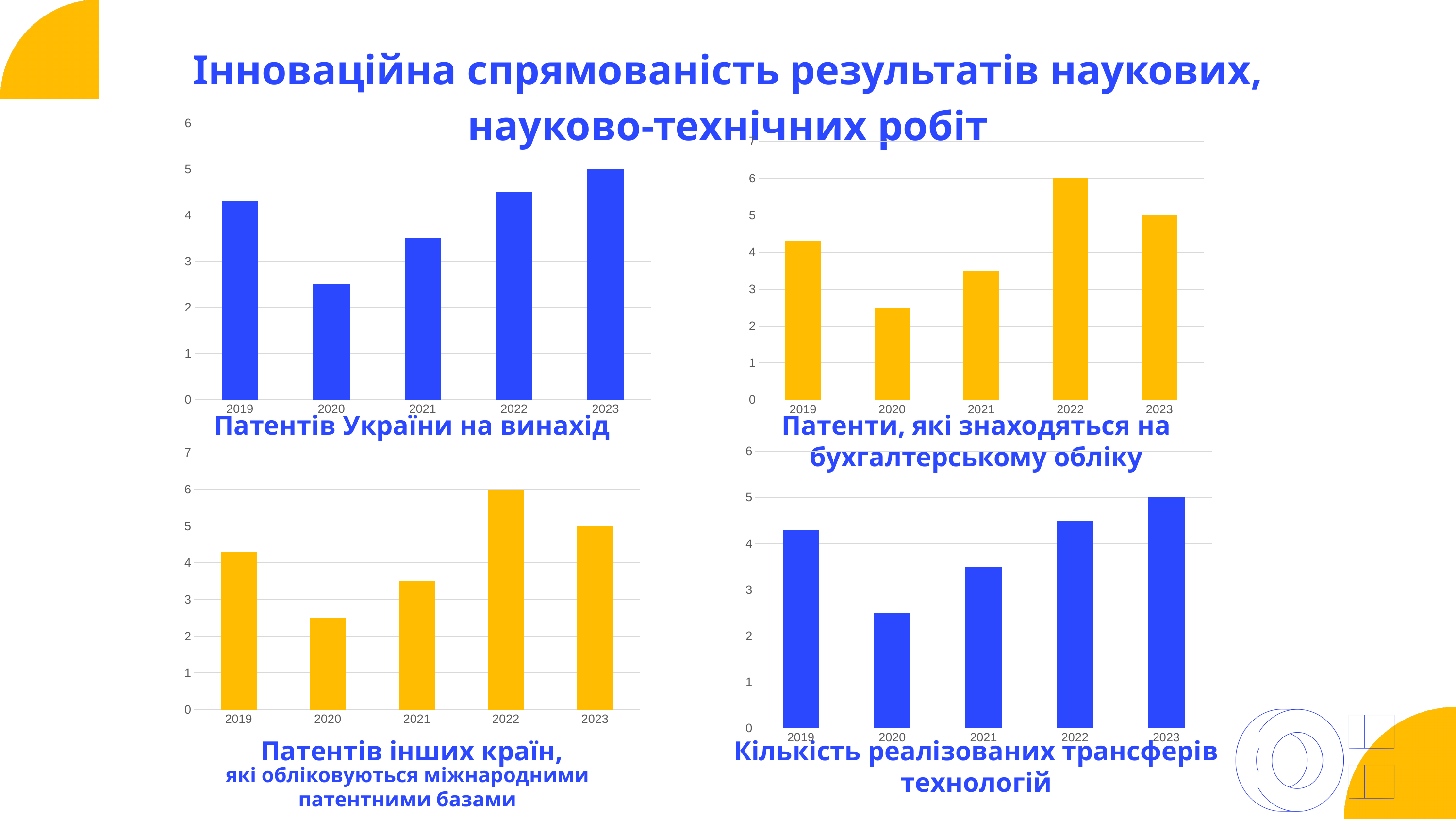
In the chart titled "Кількість реалізованих трансферів технологій" (bottom right), is the value for 2019 greater or less than 4? greater In the chart titled "Патенти, які знаходяться на бухгалтерському обліку" (top right), which year has the highest value? 2022 In the chart titled "Патентів України на винахід" (top left), how many years are shown on the x axis? 5 In the chart titled "Кількість реалізованих трансферів технологій" (bottom right), what colour are the bars? blue In the chart titled "Патентів України на винахід" (top left), what kind of chart is shown? bar chart In the chart titled "Патентів України на винахід" (top left), what is the value for 2023? 5 In the chart titled "Патентів України на винахід" (top left), which year has the highest value? 2023 In the chart titled "Патенти, які знаходяться на бухгалтерському обліку" (top right), what is the value for 2022? 6 In the chart titled "Патенти, які знаходяться на бухгалтерському обліку" (top right), is the value for 2020 greater or less than 3? less In the chart titled "Патентів інших країн" (bottom left), which year has the lowest value? 2020 In the chart titled "Патентів України на винахід" (top left), which year has the lowest value? 2020 In the chart titled "Патентів інших країн" (bottom left), which is larger, the value for 2019 or the value for 2021? 2019